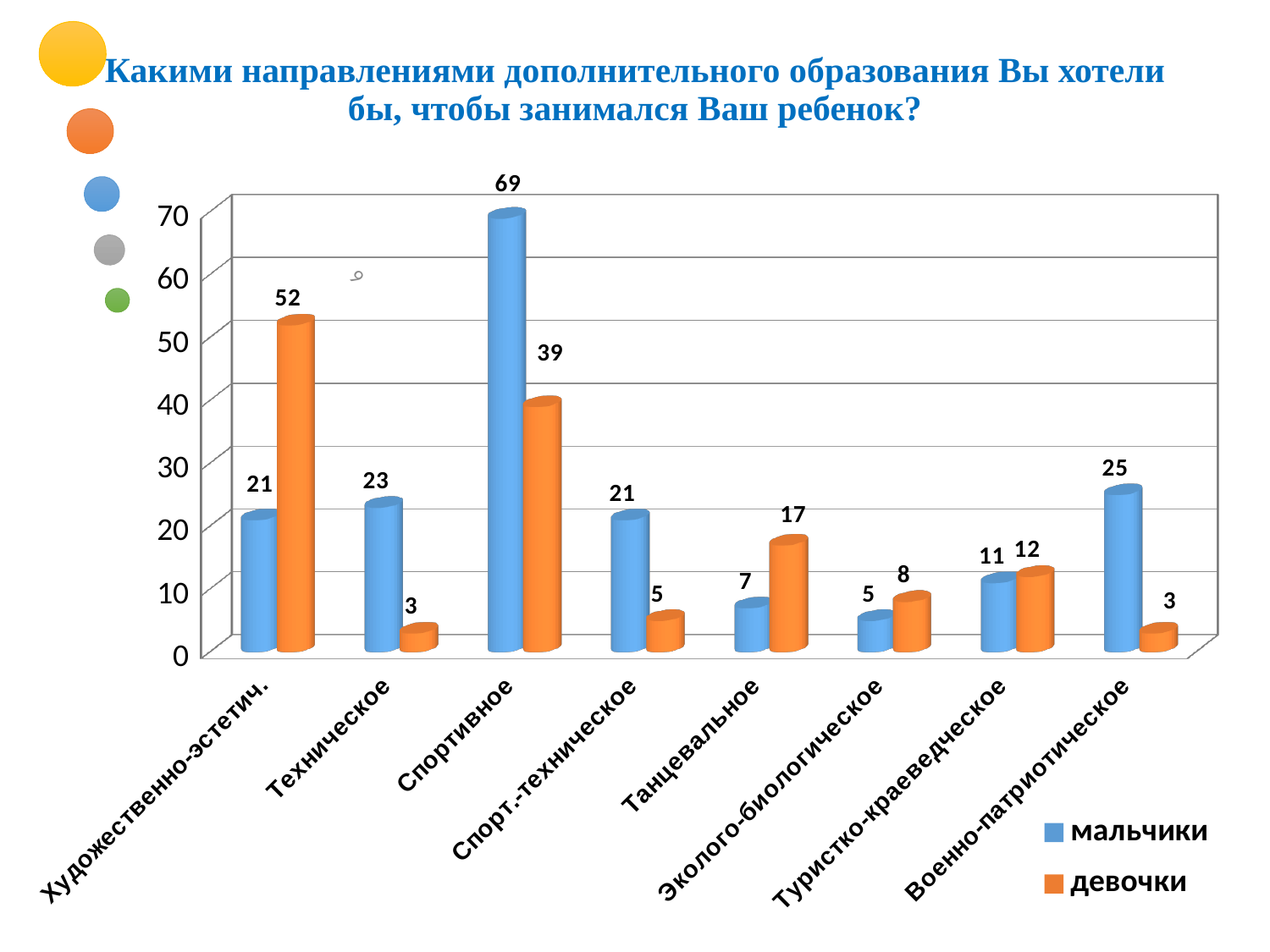
How many series does the legend list? 2 What is the value for девочки in the Танцевальное category? 17 Which category has the highest value for девочки? Художественно-эстетич. Which category has the lowest value for мальчики? Эколого-биологическое How many categories are shown on the x axis? 8 What kind of chart is shown on the slide? bar chart In the Техническое category, which is larger: мальчики or девочки? мальчики What is the value for мальчики in the Спортивное category? 69 What is the value for девочки in the Художественно-эстетич. category? 52 Which colour represents девочки in the chart? orange Which category has the highest value for мальчики? Спортивное What is the difference between the мальчики and девочки values in the Спортивное category? 30